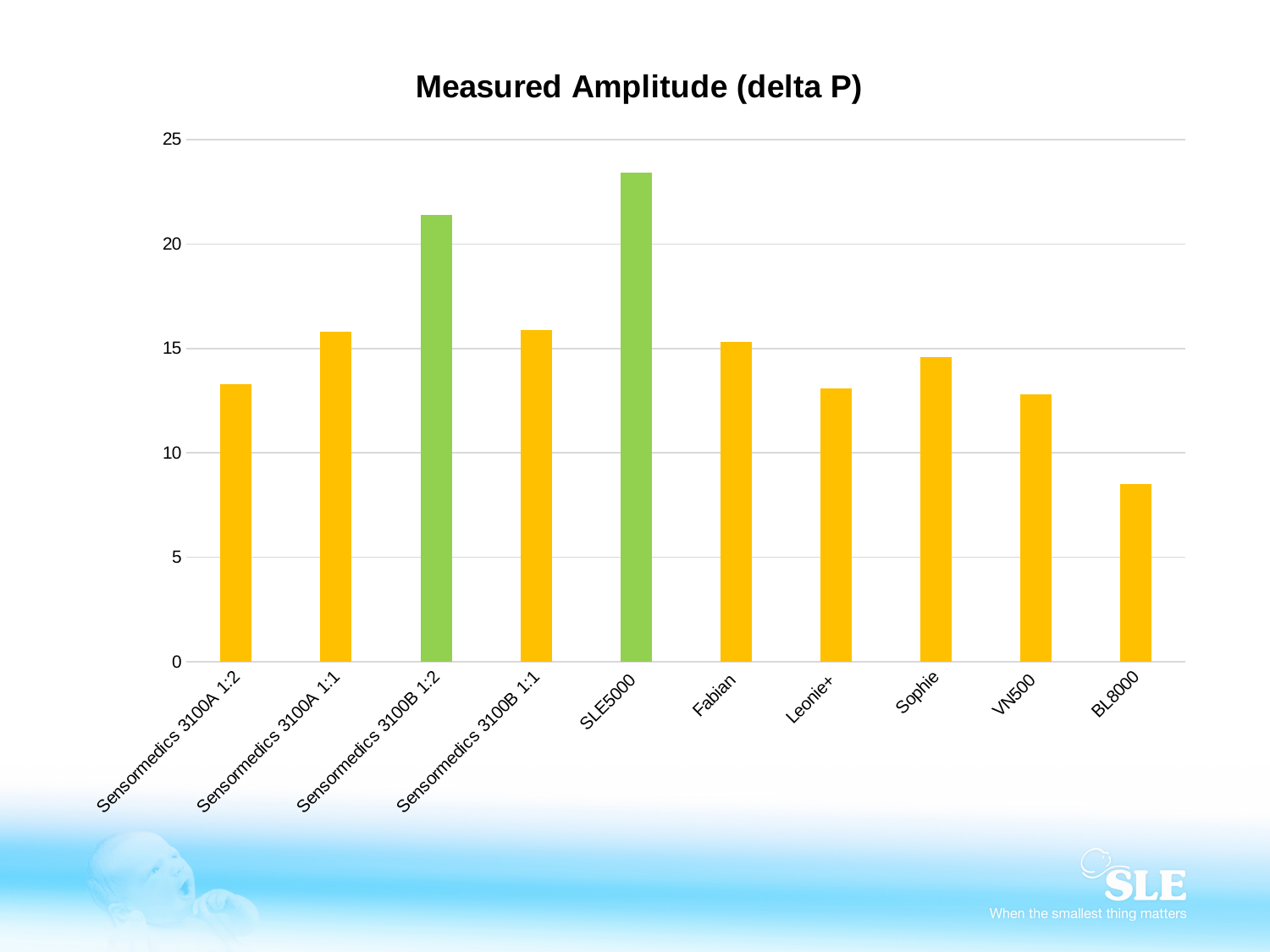
What type of chart is shown on the slide? Bar chart Which two categories are shown with green bars instead of yellow? Sensormedics 3100B 1:2 and SLE5000 Is the value for BL8000 greater or less than 10? less Is the value for Sensormedics 3100B 1:2 greater or less than 20? greater Is the value for Sophie greater or less than 15? less How many categories (ventilators) are plotted on the chart? 10 Which category has the highest measured amplitude? SLE5000 Which is larger, the value for SLE5000 or the value for Sensormedics 3100B 1:2? SLE5000 Which category has the lowest measured amplitude? BL8000 Which is larger, the value for VN500 or the value for BL8000? VN500 What is the title of the chart? Measured Amplitude (delta P)